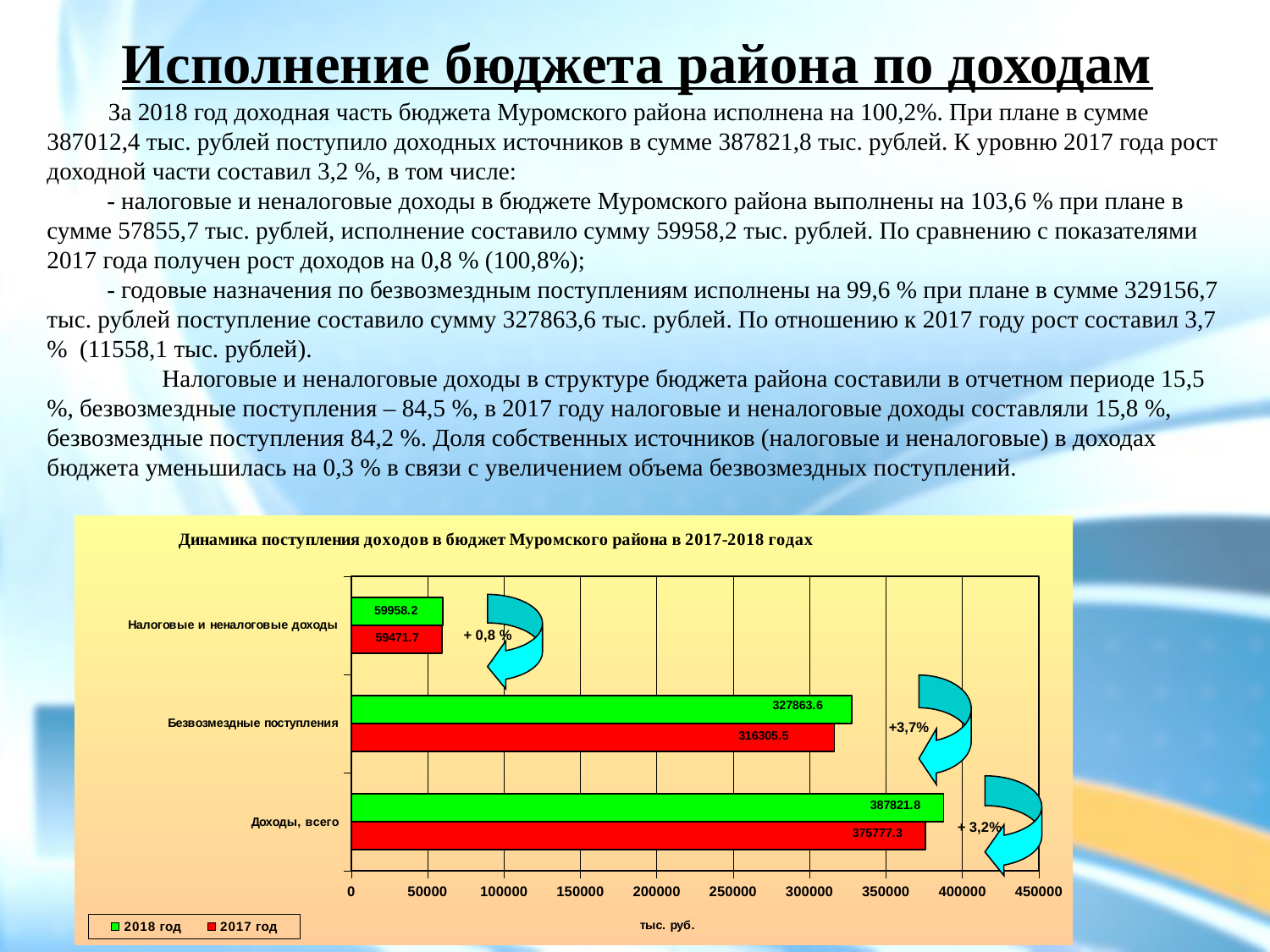
What type of chart is shown on the slide? bar chart What is the value for Налоговые и неналоговые доходы in the 2018 год series? 59958.2 Which is larger for Безвозмездные поступления: the 2018 год value or the 2017 год value? 2018 год What is the title of the chart? Динамика поступления доходов в бюджет Муромского района в 2017-2018 годах How many series does the legend list? 2 What is the value for Безвозмездные поступления in the 2017 год series? 316305.5 What is the difference between the 2018 год and 2017 год values for Доходы, всего? 12044.5 What is the difference between the 2018 год and 2017 год values for Безвозмездные поступления? 11558.1 What is the value for Доходы, всего in the 2017 год series? 375777.3 Which category has the lowest value in the 2018 год series? Налоговые и неналоговые доходы What is the value for Доходы, всего in the 2018 год series? 387821.8 Which category has the highest value in the 2017 год series? Доходы, всего